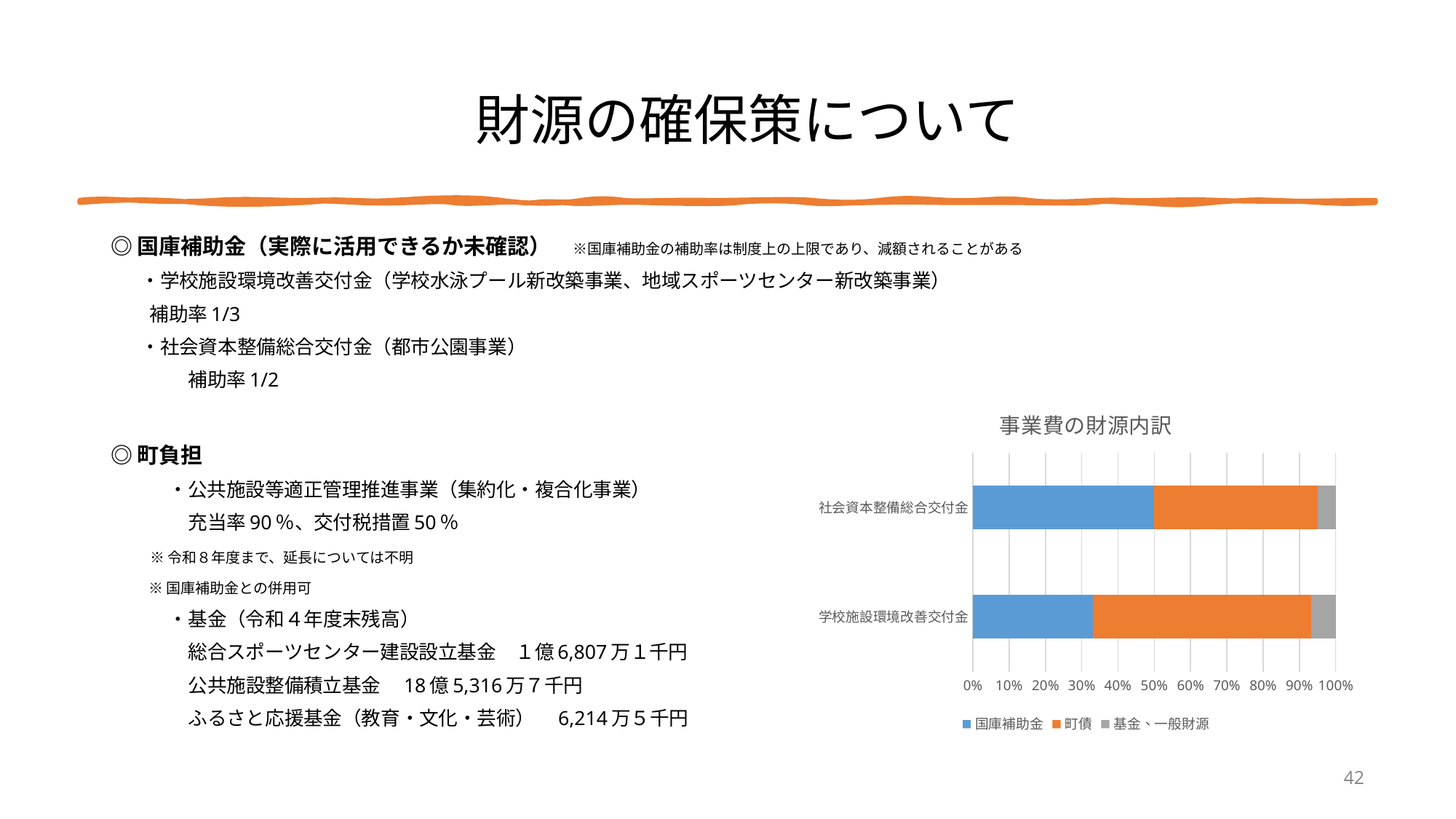
What is the title of the chart on the slide? 事業費の財源内訳 Is the 町債 share for 学校施設環境改善交付金 greater or less than 50%? greater Is the 国庫補助金 share for 学校施設環境改善交付金 greater or less than 40%? less Which category has the smallest 国庫補助金 share in the chart? 学校施設環境改善交付金 Which series is shown in orange in the chart? 町債 Which category has the larger 町債 share, 社会資本整備総合交付金 or 学校施設環境改善交付金? 学校施設環境改善交付金 How many categories are plotted in the chart? 2 What kind of chart is shown on the slide? Stacked bar chart Which category has the larger 国庫補助金 share, 社会資本整備総合交付金 or 学校施設環境改善交付金? 社会資本整備総合交付金 Is the 国庫補助金 share for 学校施設環境改善交付金 greater or less than 30%? greater How many series does the chart legend list? 3